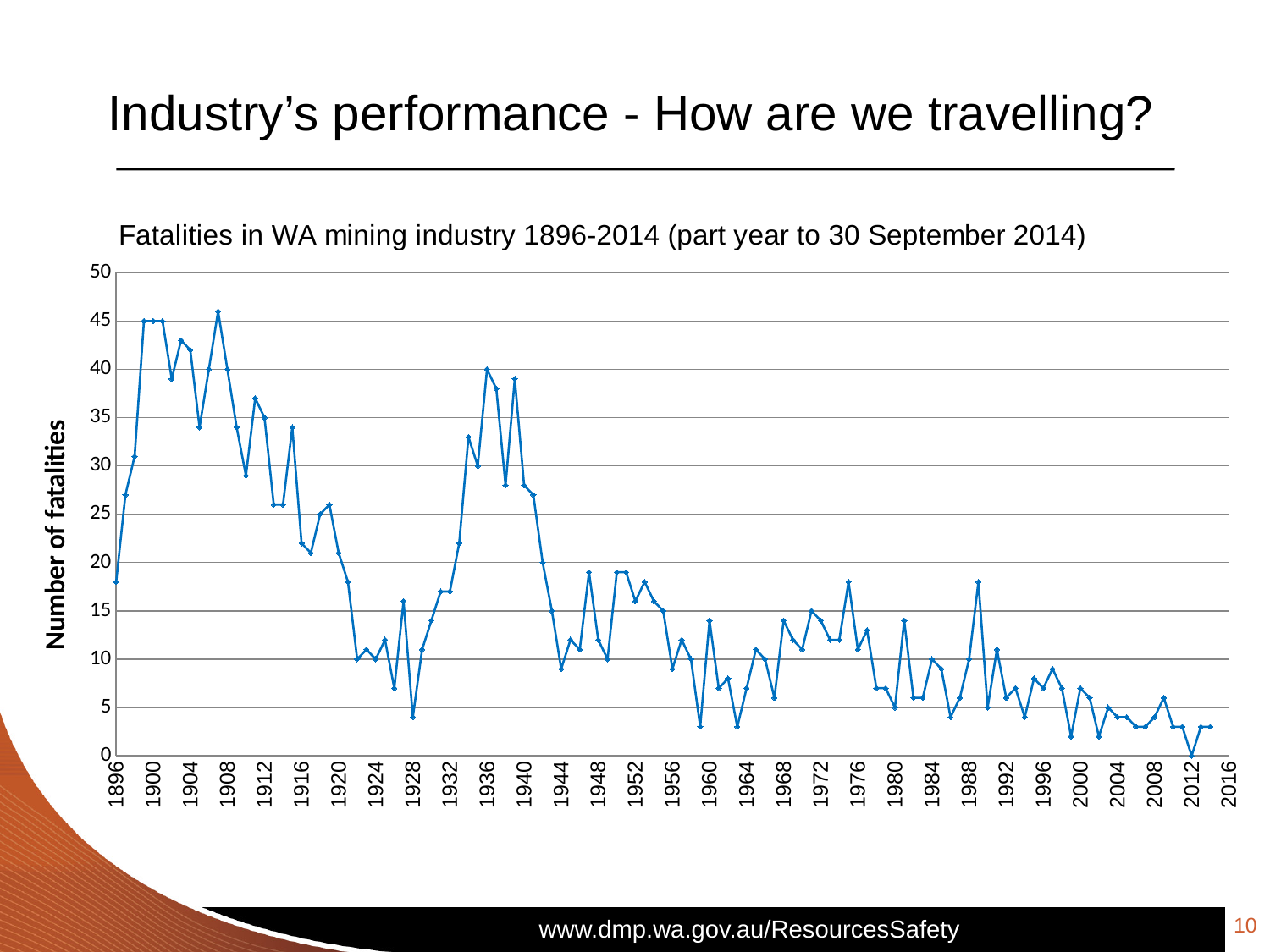
What kind of chart is shown on the slide? Line chart Is the value for 2012 greater or less than 5? less Is the value for 1960 greater or less than 5? greater Overall, do the values rise or fall from 1896 to 2014? Fall What is the title of the chart? Fatalities in WA mining industry 1896-2014 (part year to 30 September 2014) Is the value for 1896 greater or less than 20? less What is the label on the vertical axis of the chart? Number of fatalities Which is larger, the value for 1900 or the value for 2000? 1900